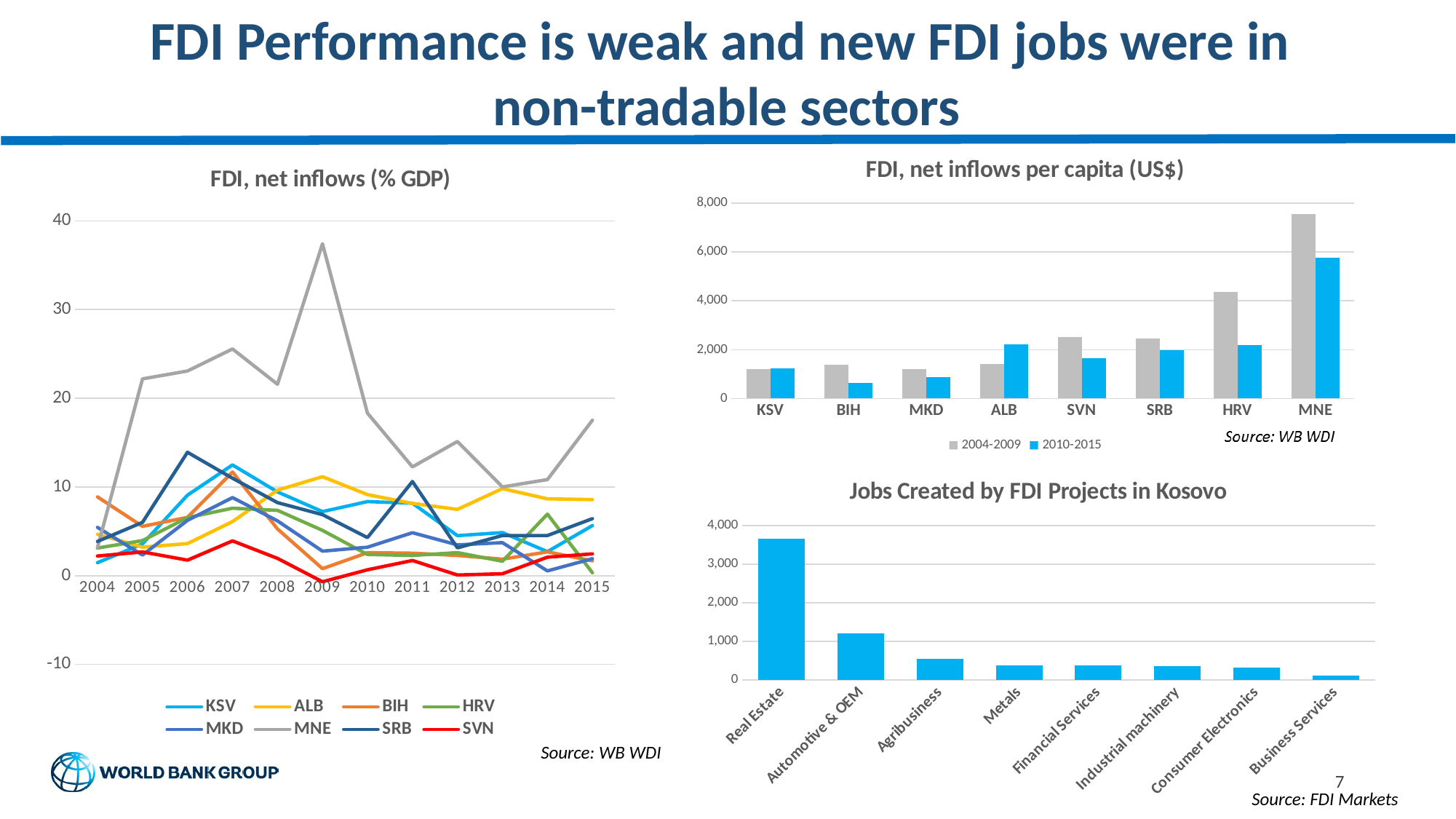
In the 'FDI, net inflows (% GDP)' chart, how many series does the legend list? 8 In the 'FDI, net inflows per capita (US$)' chart, which country has the highest value for 2004-2009? MNE What kind of chart is the 'FDI, net inflows (% GDP)' chart? line chart In the 'FDI, net inflows (% GDP)' chart, which country reaches the highest value over the period? MNE In the 'Jobs Created by FDI Projects in Kosovo' chart, is the value for Real Estate greater or less than 3,000? greater In the 'FDI, net inflows per capita (US$)' chart, for ALB, which period has the larger value, 2004-2009 or 2010-2015? 2010-2015 In the 'FDI, net inflows per capita (US$)' chart, how many series does the legend list? 2 In the 'Jobs Created by FDI Projects in Kosovo' chart, which sector has the highest value? Real Estate In the 'Jobs Created by FDI Projects in Kosovo' chart, which sector has the lowest value? Business Services In the 'FDI, net inflows per capita (US$)' chart, is the 2004-2009 value for MNE greater or less than 6,000? greater In the 'FDI, net inflows per capita (US$)' chart, is the 2010-2015 value for BIH greater or less than 1,000? less In the 'FDI, net inflows per capita (US$)' chart, how many countries are shown on the x axis? 8